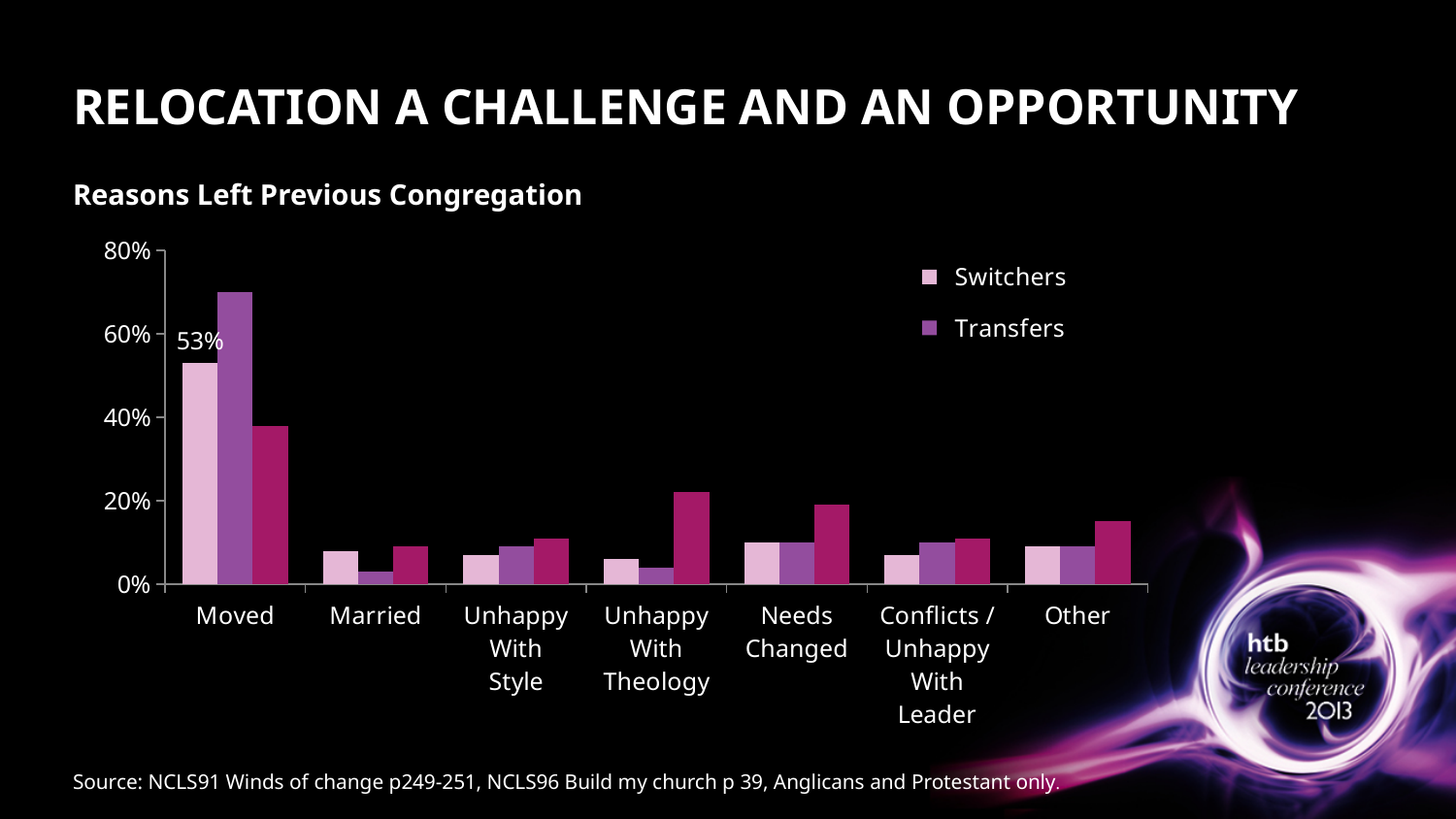
How many series does the legend list? 2 Which is larger: the Transfers value for Needs Changed or the Transfers value for Married? Needs Changed Is the Transfers value for Moved greater or less than 60%? greater What kind of chart is shown on the slide? bar chart How many categories are shown on the x axis? 7 What is the title of the chart? Reasons Left Previous Congregation Is the Switchers value for Married greater or less than 20%? less Which category has the highest Transfers value? Moved What is the Switchers value for Moved? 53% For Moved, which is larger: the Switchers value or the Transfers value? Transfers Which category has the highest Switchers value? Moved Is the Switchers value for Moved greater or less than 40%? greater